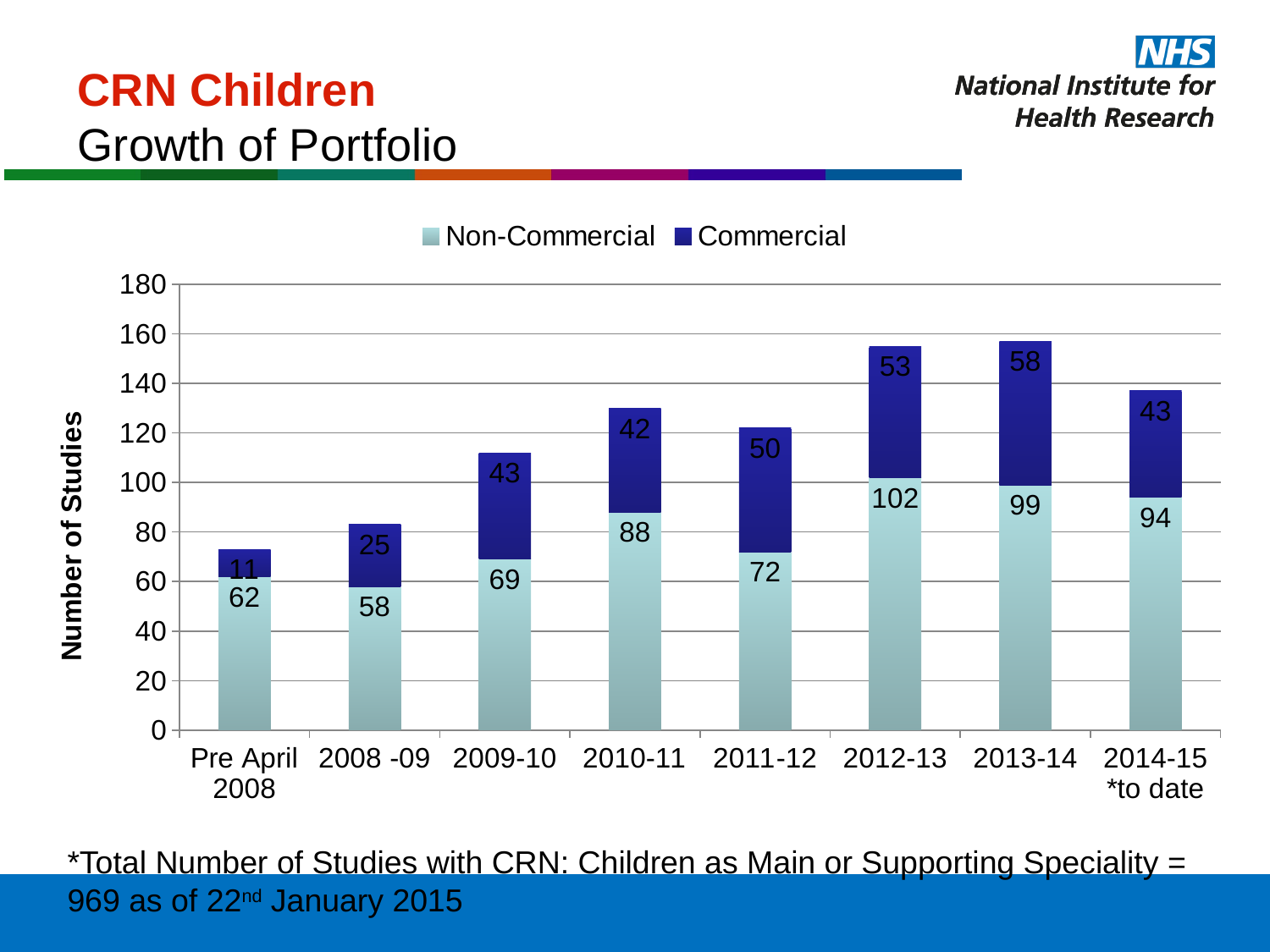
Which period has the lowest Non-Commercial value? 2008 -09 What is the label of the y axis? Number of Studies Which is larger, the Commercial value for 2009-10 or the Commercial value for 2010-11? 2009-10 How many series does the legend list? 2 What is the total number of studies in the stacked bar for Pre April 2008? 73 What kind of chart is shown on the slide? Stacked bar chart What is the total number of studies in the stacked bar for 2013-14? 157 What is the difference between the Non-Commercial values for 2010-11 and 2011-12? 16 What is the Commercial value for 2011-12? 50 How many periods are shown on the x axis? 8 Which period has the highest Commercial value? 2013-14 What is the Non-Commercial value for 2012-13? 102